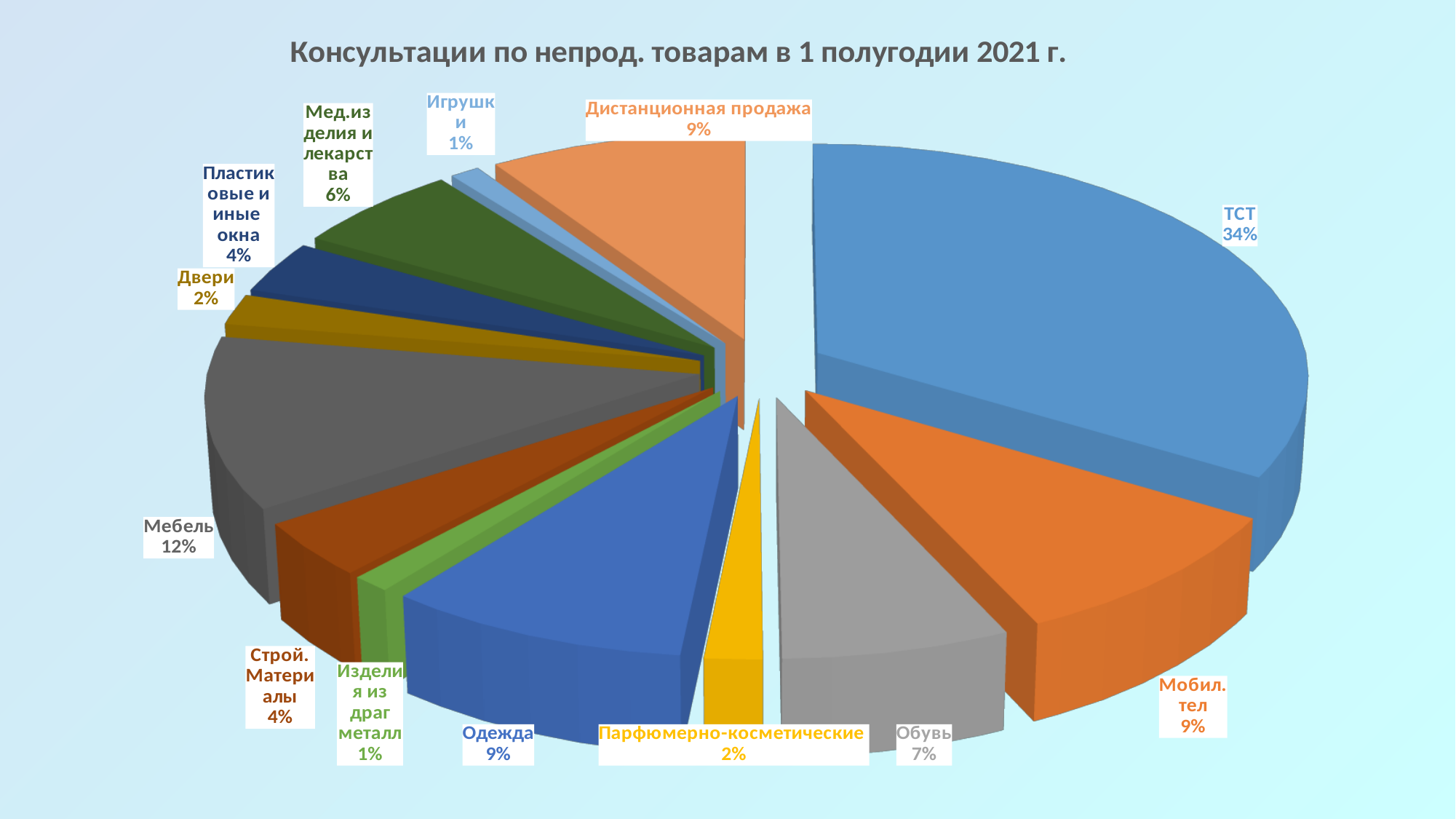
What is the difference between the shares of Мебель and Обувь? 5% What is the title of the chart? Консультации по непрод. товарам в 1 полугодии 2021 г. What is the value shown for Обувь? 7% What is the value shown for Мед.изделия и лекарства? 6% Which category has the largest share of the pie? ТСТ What kind of chart is shown on the slide? Pie chart How many categories (slices) does the pie chart have? 13 What is the value shown for Парфюмерно-косметические? 2% Which is larger, the share for Обувь or the share for Мобил. тел? Мобил. тел What is the value shown for Мебель? 12% What share of the pie does ТСТ have? 34% What is the difference between the shares of ТСТ and Мебель? 22%